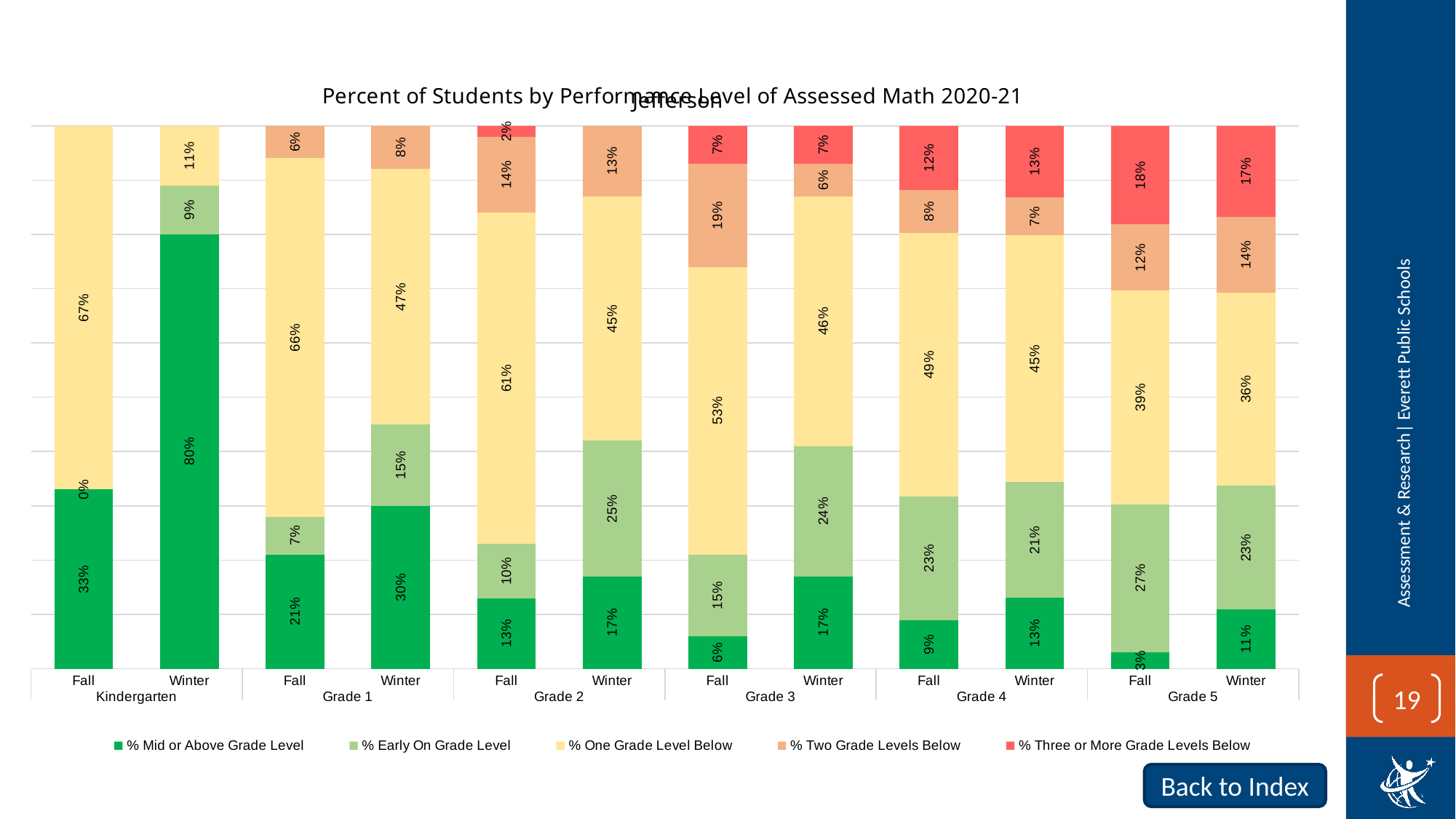
How many bars are plotted in the chart? 12 What percentage of Grade 2 Fall students are Three or More Grade Levels Below? 2% Which bar has the highest percentage of students Mid or Above Grade Level? Kindergarten Winter What percentage of Grade 3 Fall students are Two Grade Levels Below? 19% What kind of chart is shown on the slide? Stacked bar chart How many series does the legend list? 5 Which colour represents % Three or More Grade Levels Below in the legend? Red What percentage of Grade 5 Winter students are One Grade Level Below? 36% What percentage of Kindergarten Winter students are Mid or Above Grade Level? 80% Which bar has the lowest percentage of students Mid or Above Grade Level? Grade 5 Fall What is the difference between the Mid or Above Grade Level percentages for Grade 1 Winter and Grade 1 Fall? 9% Which is larger: the Early On Grade Level percentage for Grade 2 Winter or for Grade 2 Fall? Grade 2 Winter